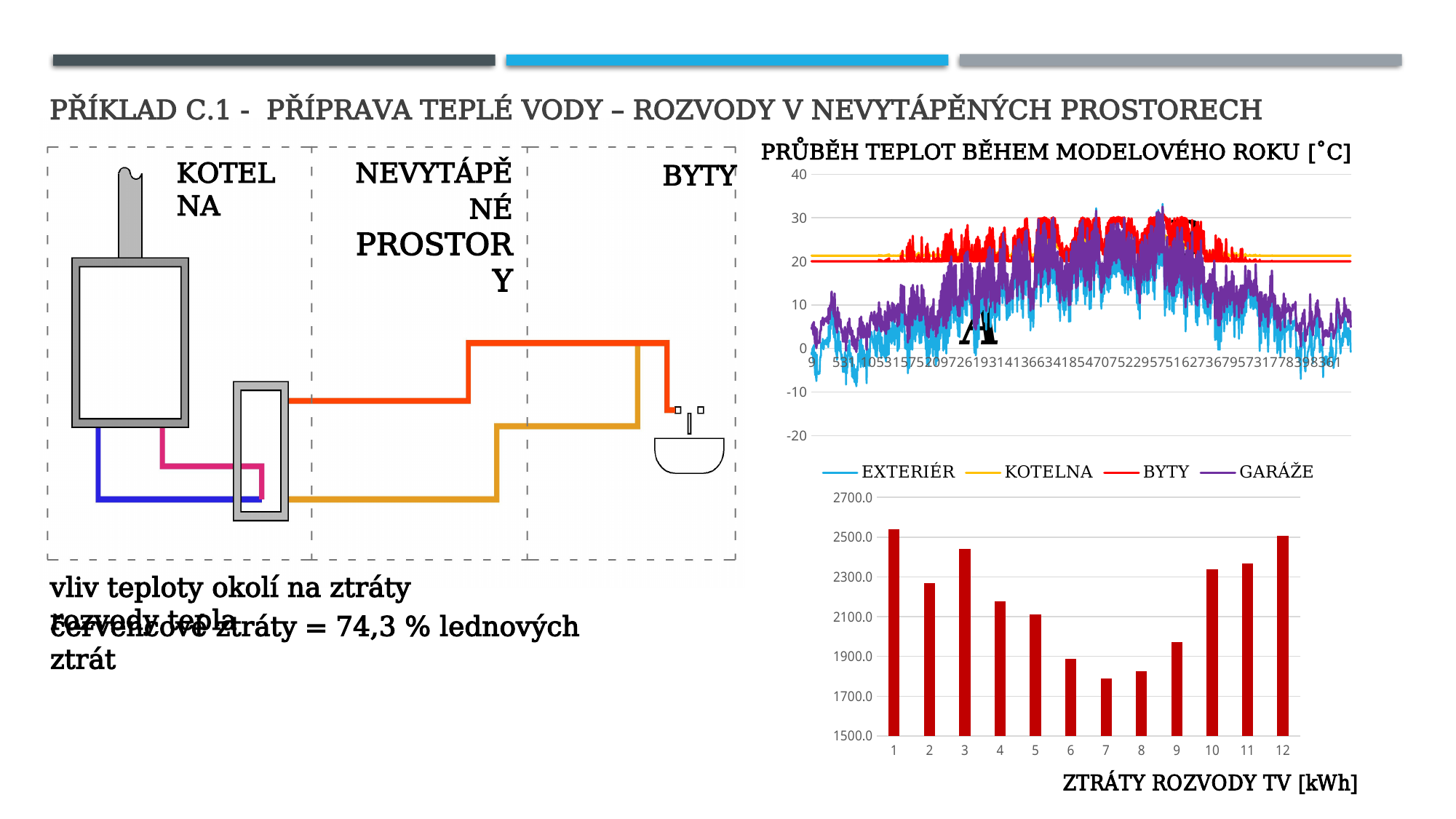
What kind of chart is the chart titled ZTRÁTY ROZVODY TV [kWh]? bar chart In the chart ZTRÁTY ROZVODY TV [kWh], is the value for category 7 greater or less than 1900? less In the chart ZTRÁTY ROZVODY TV [kWh], is the value for category 9 greater or less than 2100? less How many bars are there in the chart ZTRÁTY ROZVODY TV [kWh]? 12 In the chart ZTRÁTY ROZVODY TV [kWh], which is larger, the value for category 3 or category 4? 3 In the chart ZTRÁTY ROZVODY TV [kWh], which is larger, the value for category 8 or category 9? 9 In the chart ZTRÁTY ROZVODY TV [kWh], is the value for category 3 greater or less than 2300? greater What kind of chart is the chart titled PRŮBĚH TEPLOT BĚHEM MODELOVÉHO ROKU [°C]? line chart In the chart PRŮBĚH TEPLOT BĚHEM MODELOVÉHO ROKU [°C], which series is shown in red? BYTY How many series does the legend of the chart PRŮBĚH TEPLOT BĚHEM MODELOVÉHO ROKU [°C] list? 4 In the chart PRŮBĚH TEPLOT BĚHEM MODELOVÉHO ROKU [°C], which series is shown in purple? GARÁŽE In the chart ZTRÁTY ROZVODY TV [kWh], which category has the lowest value? 7